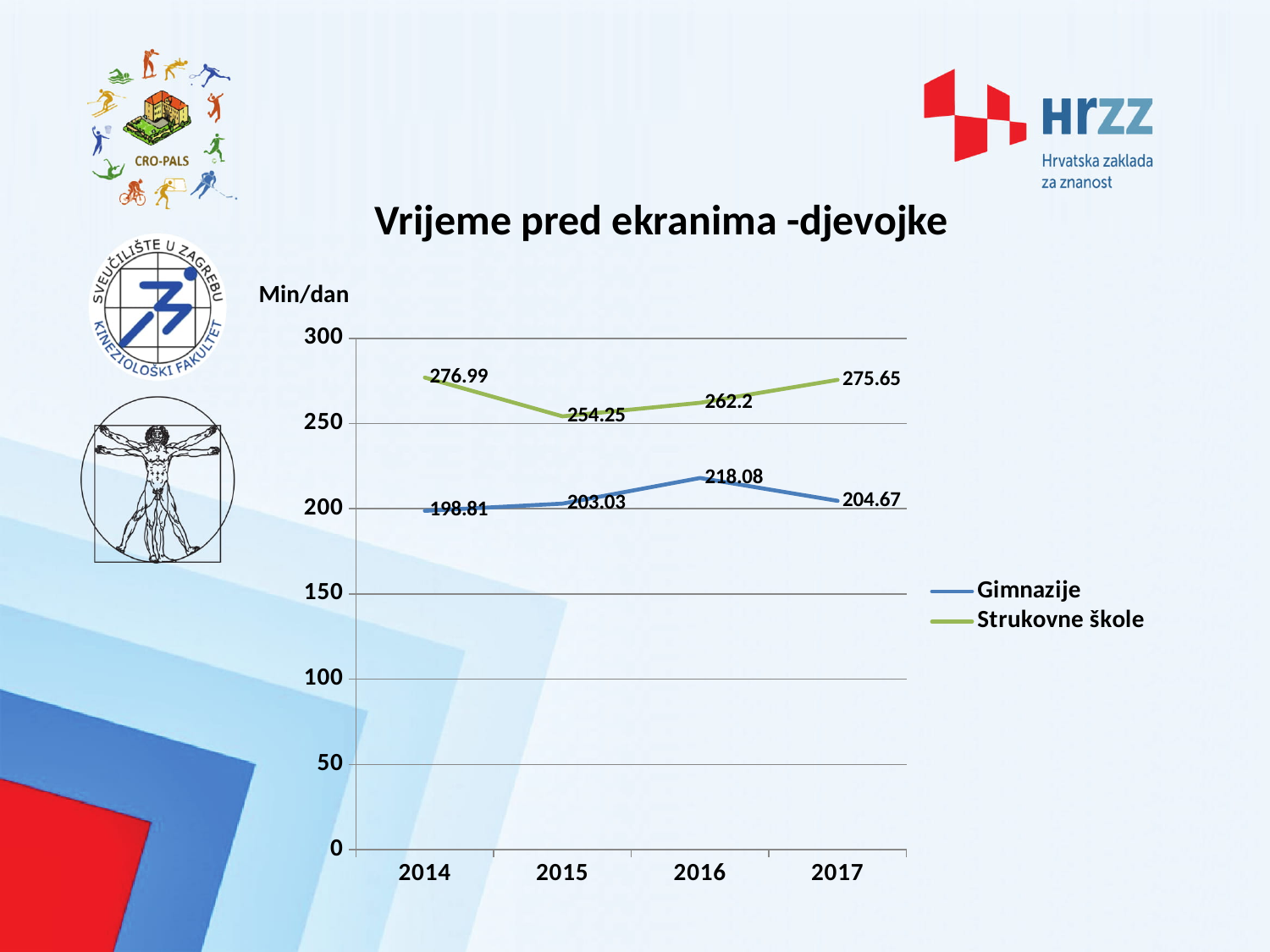
How many years are shown on the x axis? 4 What kind of chart is shown? line chart What is the difference between Strukovne škole and Gimnazije in 2016? 44.12 What is the value for Strukovne škole in 2015? 254.25 In which year is the Gimnazije value highest? 2016 How many series does the legend list? 2 What is the value for Gimnazije in 2014? 198.81 What is the title of the chart? Vrijeme pred ekranima -djevojke Which series has the larger value in 2017, Gimnazije or Strukovne škole? Strukovne škole Is the value for Gimnazije in 2016 greater or less than 200? greater What is the value for Strukovne škole in 2017? 275.65 In which year is the Strukovne škole value lowest? 2015